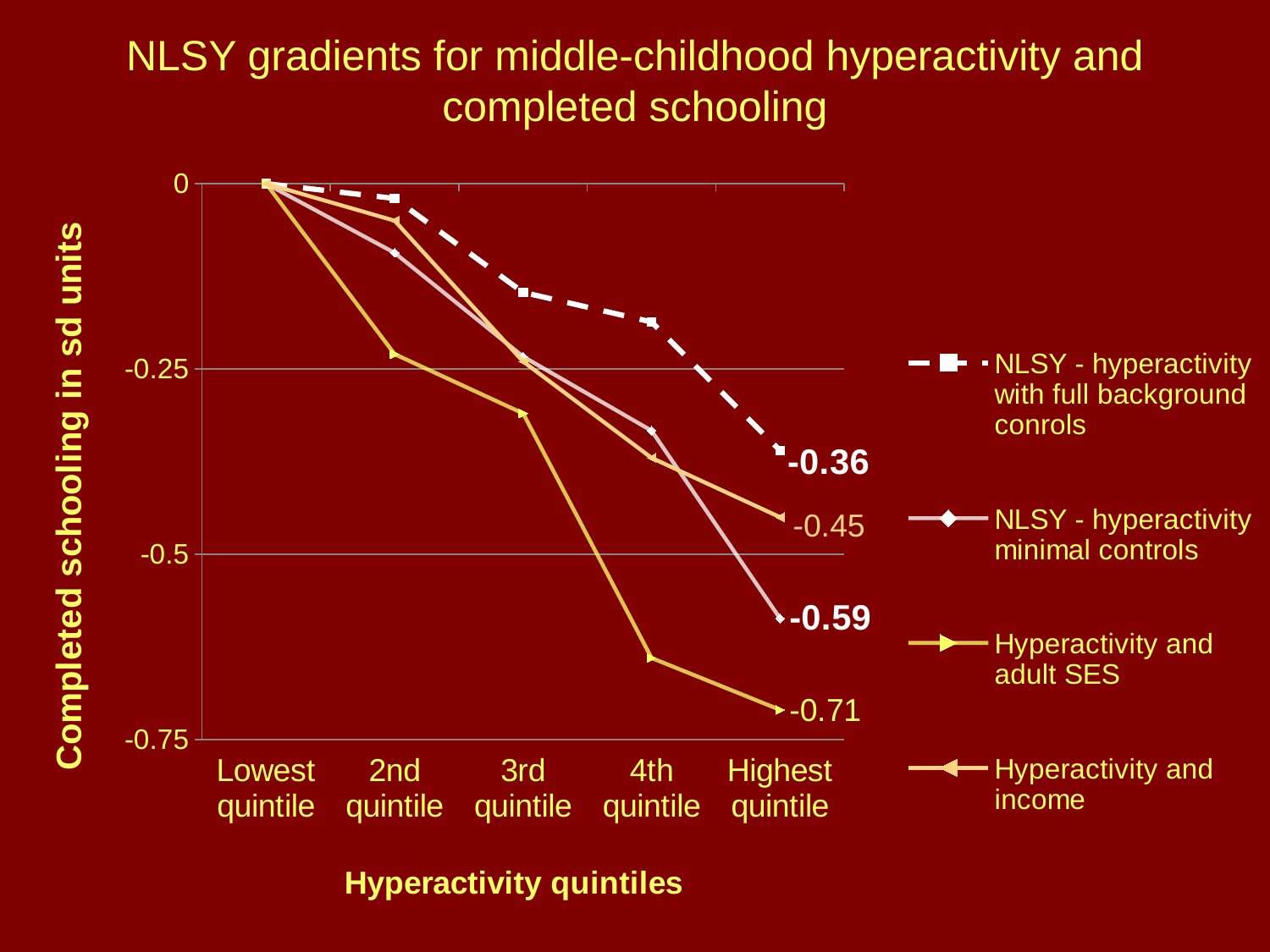
Is the value for 'Hyperactivity and adult SES' at the 4th quintile greater or less than -0.5? less What is the value for 'Hyperactivity and adult SES' at the Highest quintile? -0.71 What is the value for 'Hyperactivity and income' at the Highest quintile? -0.45 Which series has the lowest value at the Highest quintile? Hyperactivity and adult SES How many series does the legend list? 4 Do the values for 'Hyperactivity and adult SES' rise or fall from the Lowest quintile to the Highest quintile? fall What is the title of the y axis? Completed schooling in sd units What is the difference between the Highest quintile values for 'NLSY - hyperactivity minimal controls' and 'NLSY - hyperactivity with full background conrols'? 0.23 How many hyperactivity quintile categories are shown on the x axis? 5 What is the value for 'NLSY - hyperactivity minimal controls' at the Highest quintile? -0.59 What kind of chart is shown on the slide? line chart What is the value for 'NLSY - hyperactivity with full background conrols' at the Highest quintile? -0.36